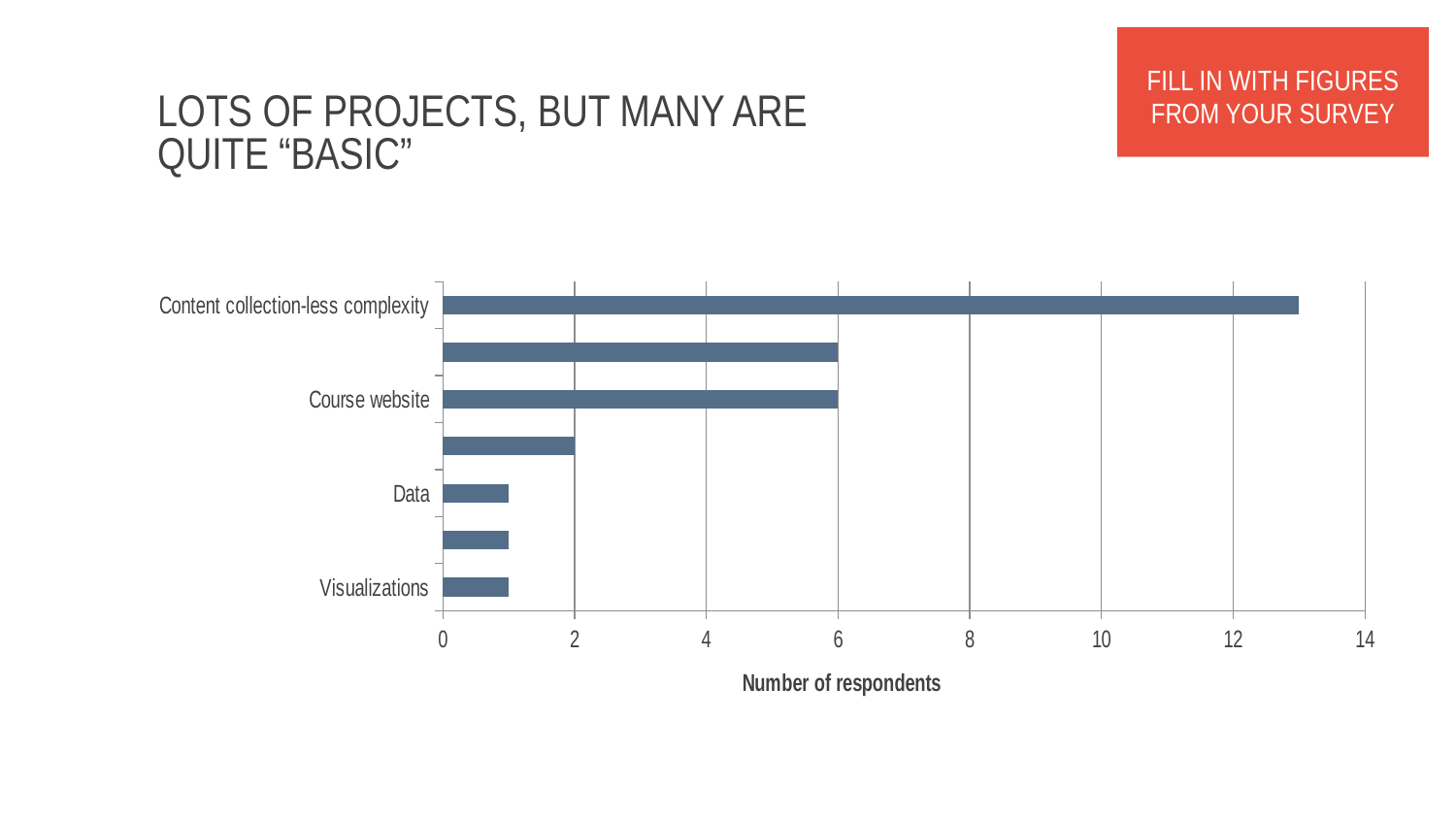
What is the label of the horizontal axis? Number of respondents Is the value for Visualizations greater or less than 2? less Which has more respondents, Course website or Data? Course website How many bars are plotted in the chart? 7 Is the value for Data greater or less than 2? less Is the value for Content collection-less complexity greater or less than 12? greater What is the number of respondents for Course website? 6 Which category has the highest number of respondents? Content collection-less complexity Which has more respondents, Content collection-less complexity or Course website? Content collection-less complexity What is the maximum value shown on the horizontal axis? 14 What kind of chart is shown on the slide? bar chart